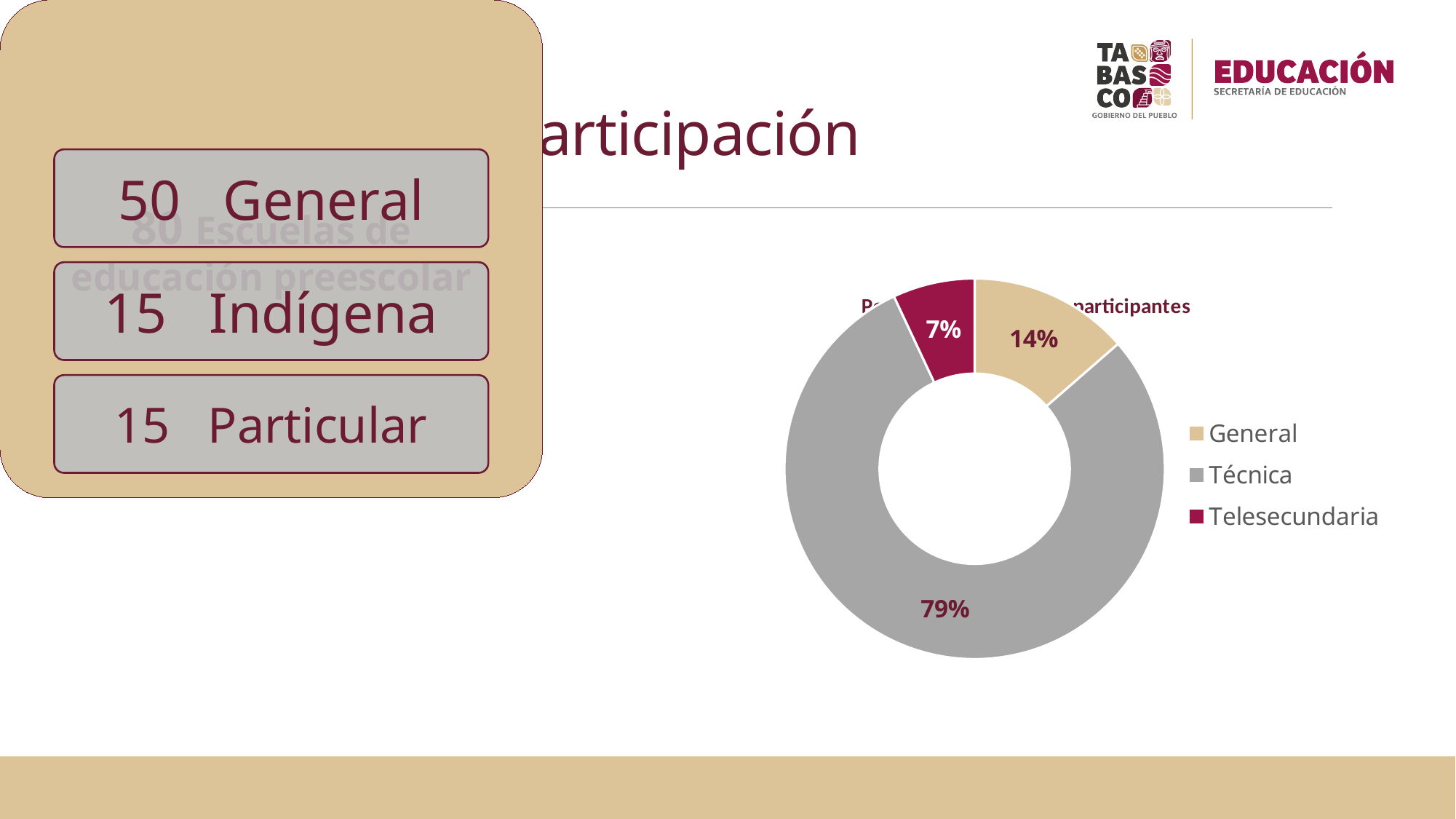
What share of the doughnut chart does General represent? 14% What is the difference in percentage points between the General and Telesecundaria slices? 7 What kind of chart is shown on the slide? doughnut chart How many categories are shown in the doughnut chart? 3 How many entries does the chart legend list? 3 What is the difference in percentage points between the Técnica and General slices? 65 Which category has the smallest slice in the doughnut chart? Telesecundaria Which category has the largest slice in the doughnut chart? Técnica What share of the doughnut chart does Telesecundaria represent? 7% What colour is the Telesecundaria slice in the doughnut chart? dark red What share of the doughnut chart does Técnica represent? 79% Which slice is larger, General or Telesecundaria? General